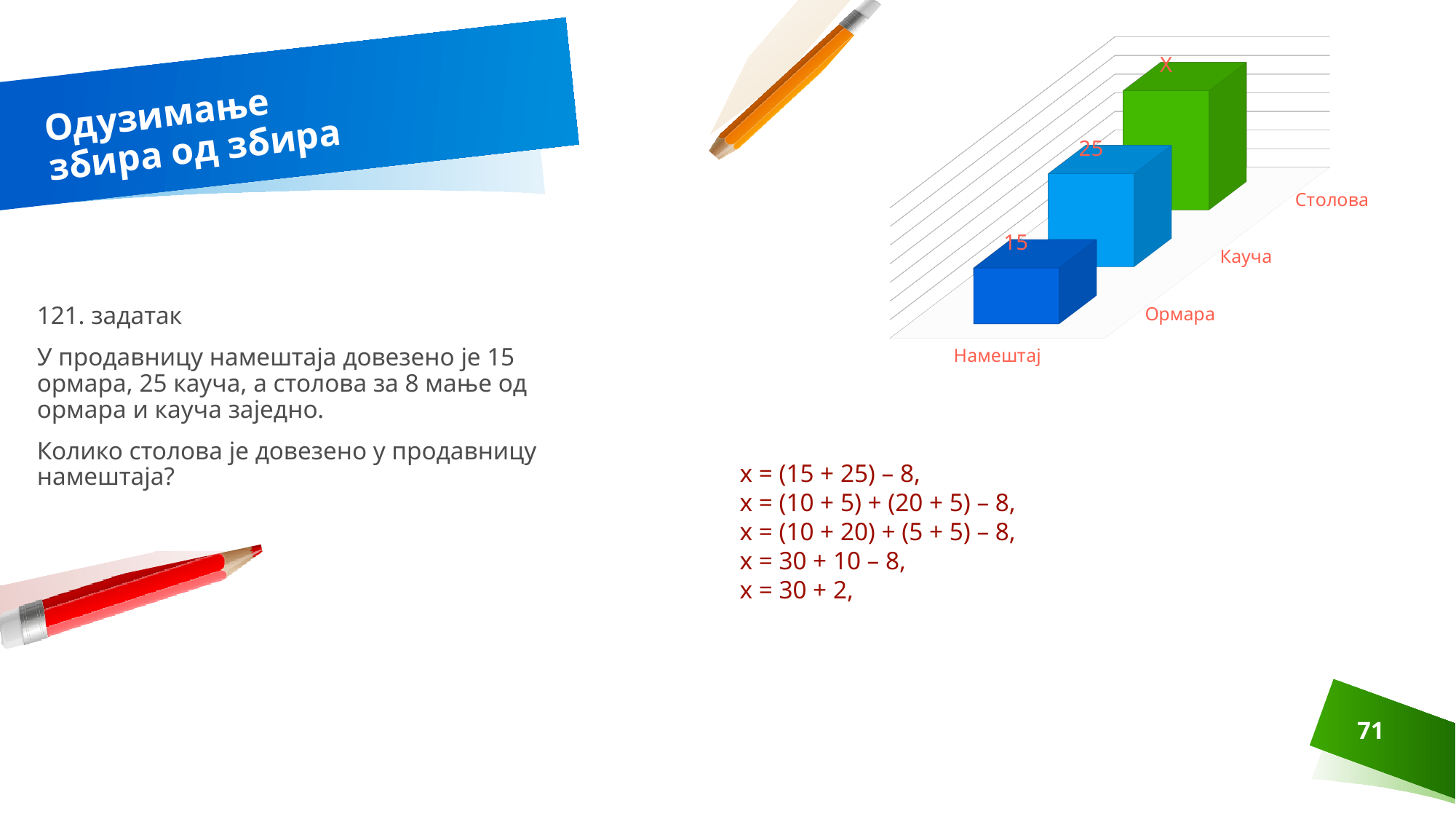
What value is shown for Кауча in the chart? 25 Which category has the tallest bar in the chart? Столова Which is larger, the value for Кауча or the value for Ормара? Кауча Do the bars rise or fall from Ормара to Столова? rise What kind of chart is shown on the slide? bar chart How many categories are shown in the chart? 3 What is the difference between the values for Кауча and Ормара? 10 What value is shown for Ормара in the chart? 15 What is the axis label printed below the categories in the chart? Намештај What colour is the Столова bar in the chart? green What label is printed above the Столова bar in the chart? x Which category has the shortest bar in the chart? Ормара